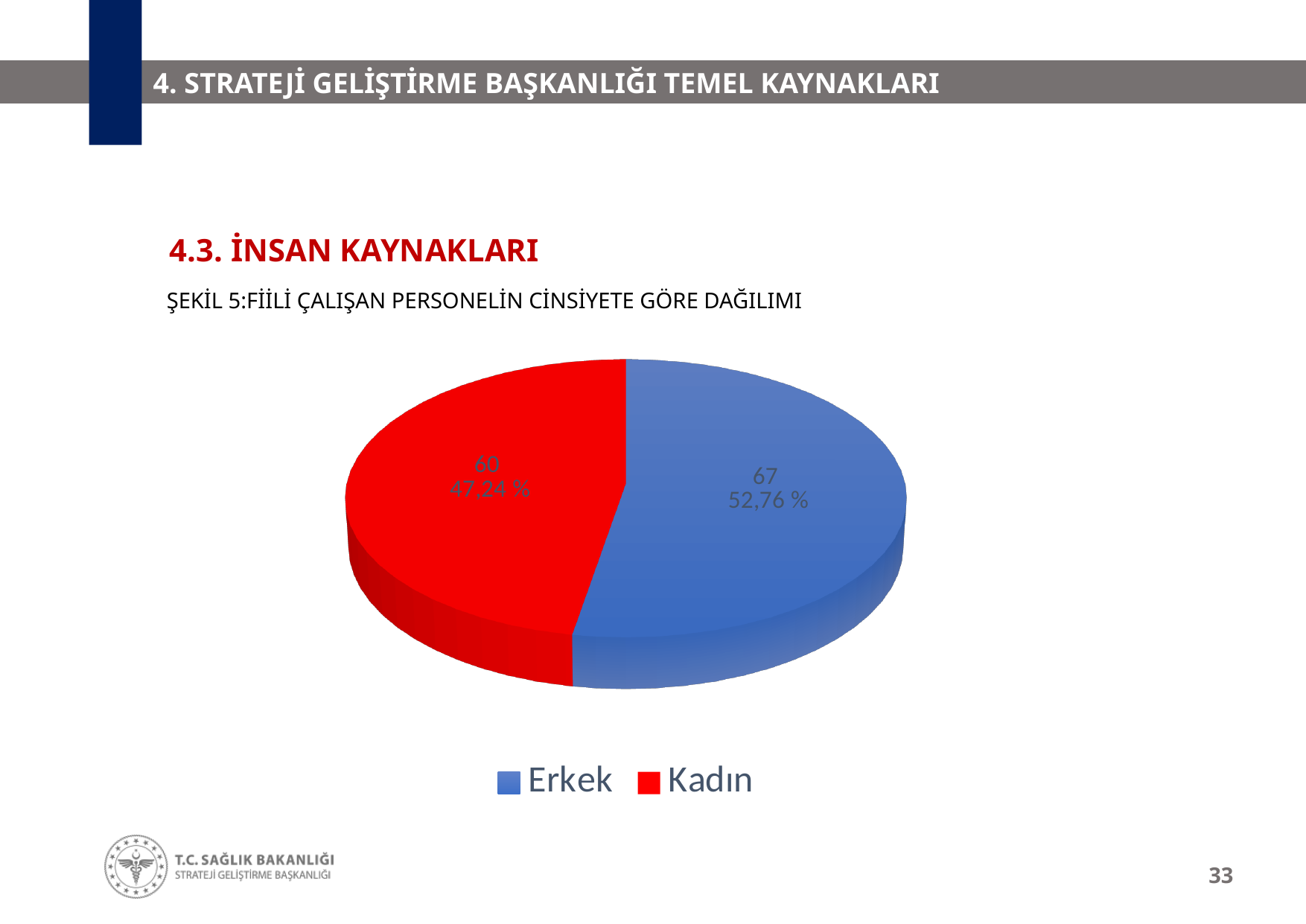
What percentage share does the Erkek slice have? 52,76 % What type of chart is shown on the slide? pie chart What colour is the Kadın slice? red What percentage share does the Kadın slice have? 47,24 % Which is larger, the Erkek slice or the Kadın slice? Erkek Which category has the largest slice? Erkek How many people are in the Kadın slice? 60 How many categories does the pie chart have? 2 What is the difference between the Erkek and Kadın counts? 7 What is the total number of people represented in the pie chart? 127 How many people are in the Erkek slice? 67 Which category has the smallest slice? Kadın